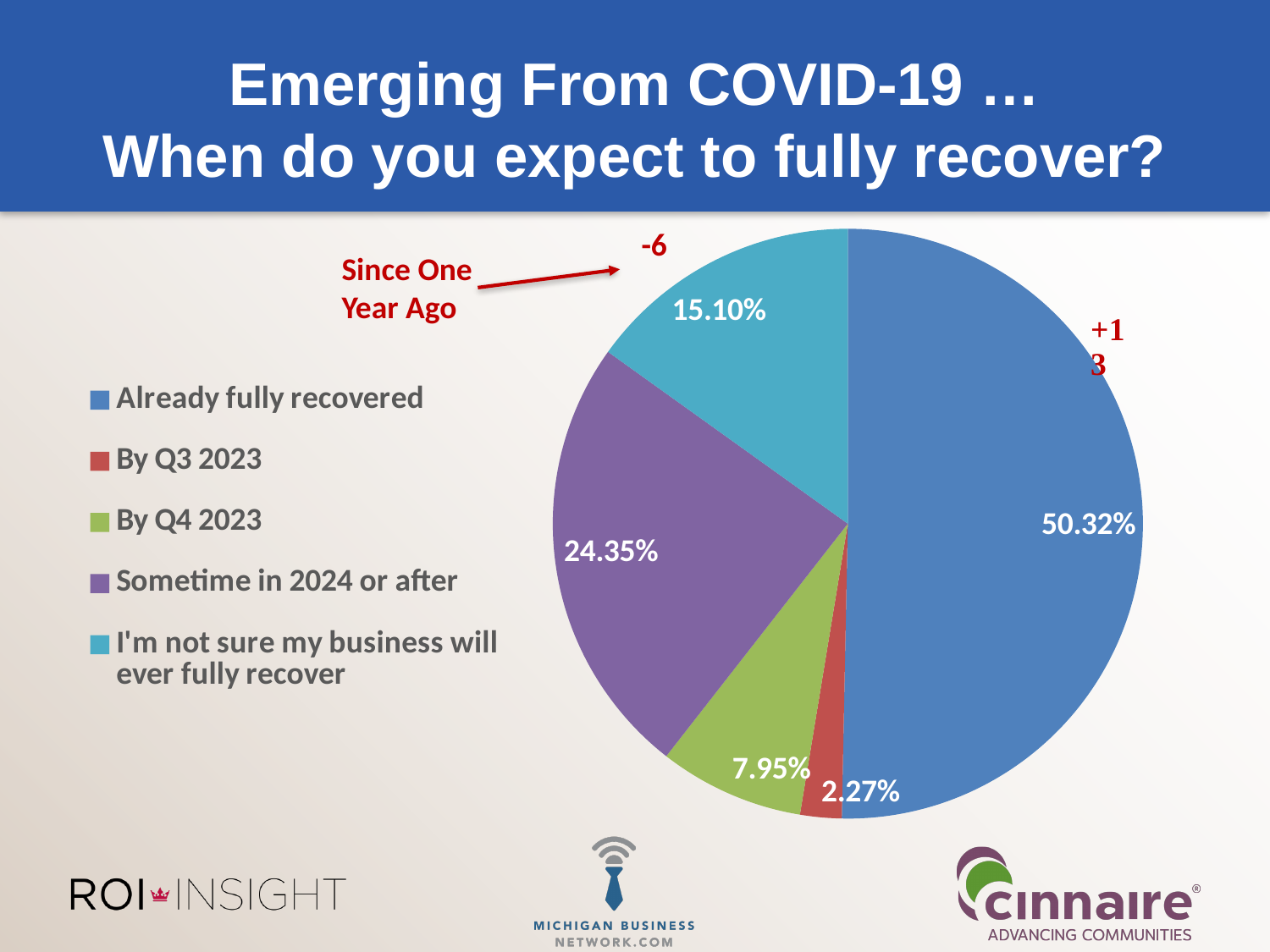
What percentage of respondents expect to recover by Q4 2023? 7.95% What percentage of respondents said they have already fully recovered? 50.32% Which response category has the smallest share of the pie? By Q3 2023 What percentage of respondents are not sure their business will ever fully recover? 15.10% What percentage of respondents expect to recover sometime in 2024 or after? 24.35% Which is larger: the share for 'Sometime in 2024 or after' or the share for 'I'm not sure my business will ever fully recover'? Sometime in 2024 or after Which response category has the largest share of the pie? Already fully recovered What kind of chart is shown on the slide? Pie chart What is the difference in percentage points between 'Already fully recovered' and 'Sometime in 2024 or after'? 25.97 How many categories does the pie chart have? 5 What percentage of respondents expect to recover by Q3 2023? 2.27% What colour is the slice for 'Already fully recovered'? Blue